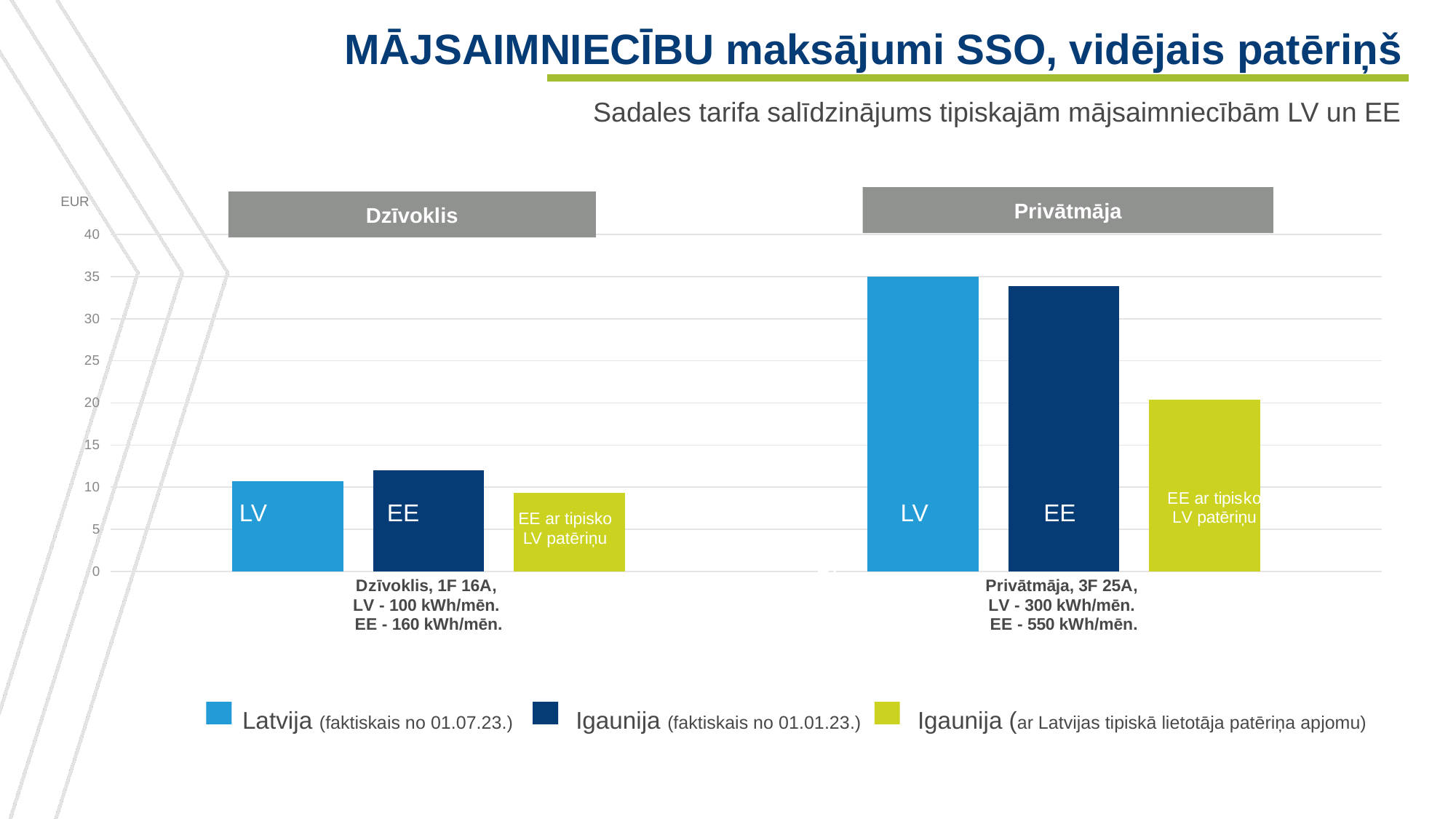
Is the value for EE ar tipisko LV patēriņu in the Privātmāja group greater or less than 25? less Is the value for LV in the Privātmāja group greater or less than 30? greater Is the value for EE ar tipisko LV patēriņu in the Dzīvoklis group greater or less than 10? less How many series does the legend list? 3 In the Dzīvoklis group, which bar is the highest? EE What kind of chart is shown on the slide? bar chart In the Privātmāja group, which bar is the lowest? EE ar tipisko LV patēriņu How many household groups (categories) are shown on the chart? 2 What unit is shown on the vertical axis of the chart? EUR Which is larger: the LV bar in the Dzīvoklis group or the LV bar in the Privātmāja group? Privātmāja In the Dzīvoklis group, which is larger: the EE bar or the EE ar tipisko LV patēriņu bar? EE In the Dzīvoklis group, which bar is the lowest? EE ar tipisko LV patēriņu